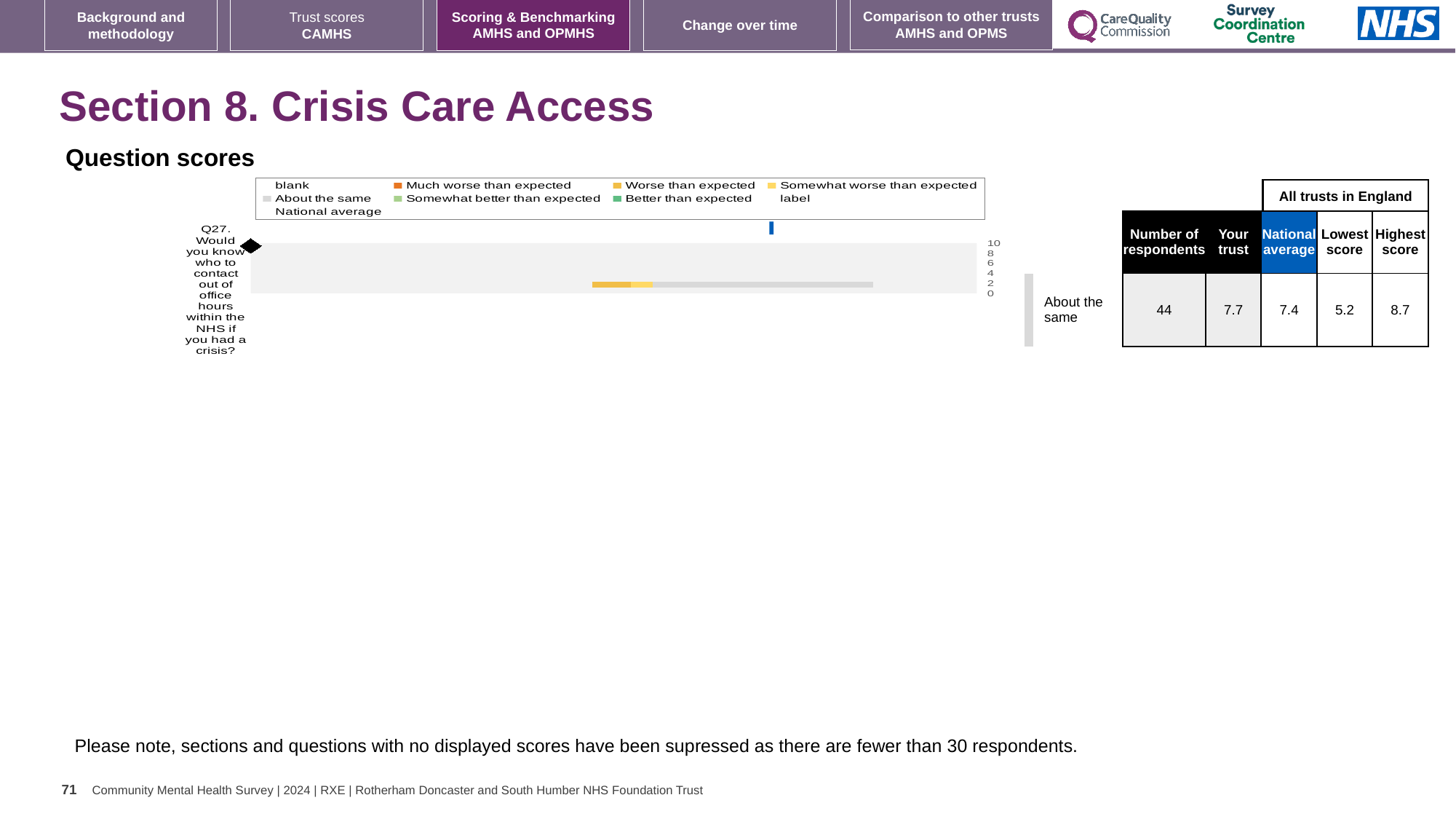
What is the highest value shown on the chart's score axis? 10 What is the Lowest score among all trusts in England for Q27? 5.2 What benchmark category label is shown to the right of the bar for Q27? About the same How many questions are plotted in the Question scores chart? 1 For Q27, which is larger: the Your trust score or the National average? Your trust What is the number of respondents for Q27? 44 Which question is plotted in the Question scores chart? Q27. Would you know who to contact out of office hours within the NHS if you had a crisis? What is the Highest score among all trusts in England for Q27? 8.7 For Q27, what is the difference between the Your trust score and the National average? 0.3 What is the National average score for Q27? 7.4 What kind of chart is shown under "Question scores"? bar chart What is the "Your trust" score for Q27? 7.7